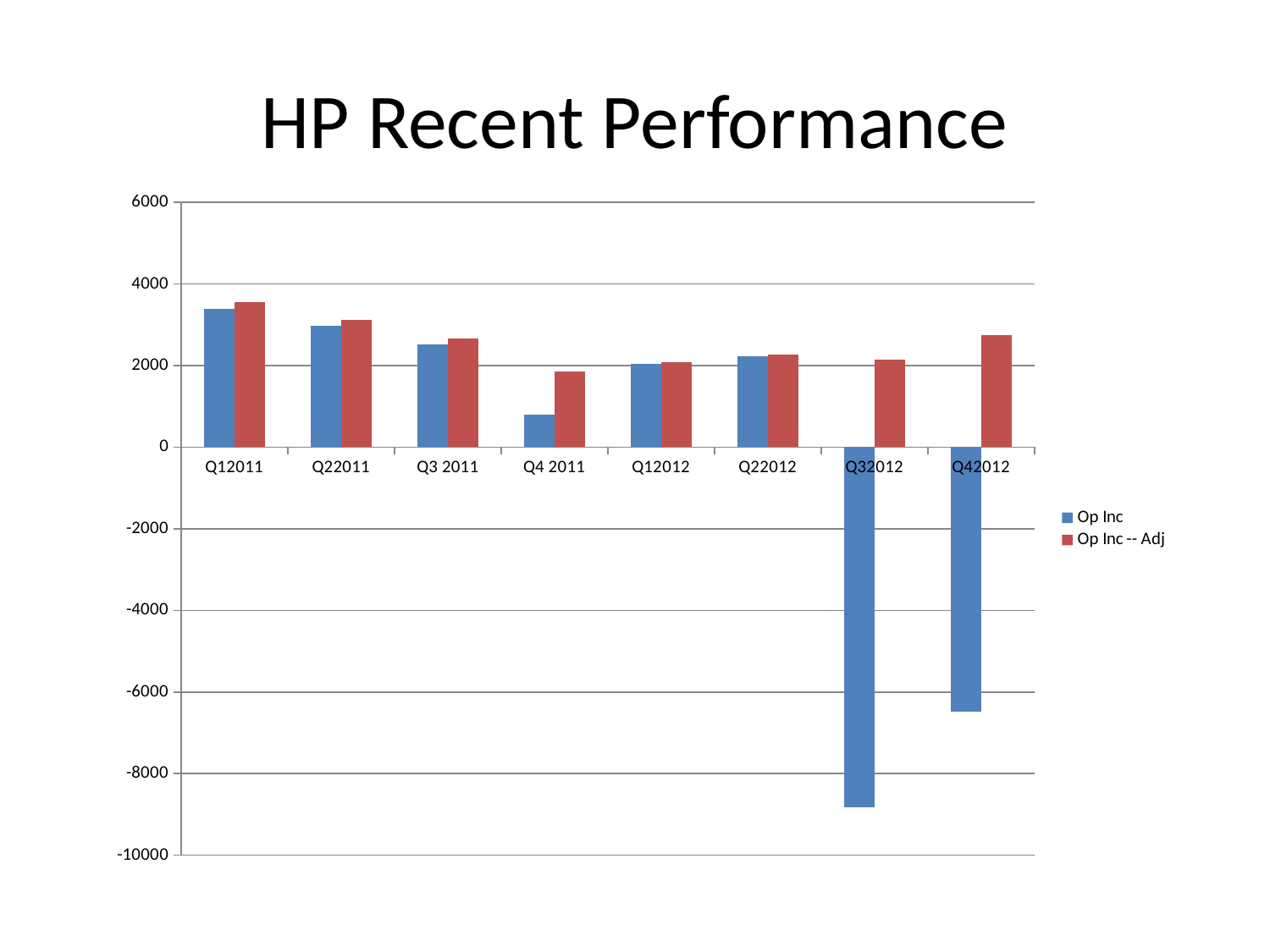
How many quarters are shown on the x axis of the chart? 8 Is the Op Inc value for Q32012 greater or less than -8000? less Which quarter has the lowest Op Inc value? Q32012 For Q4 2011, which is larger: Op Inc or Op Inc -- Adj? Op Inc -- Adj Is the Op Inc value for Q4 2011 greater or less than 2000? less Is the Op Inc -- Adj value for Q42012 greater or less than 2000? greater Do the Op Inc values rise or fall from Q12011 to Q3 2011? fall How many series does the legend list? 2 Which quarter has the highest Op Inc -- Adj value? Q12011 Which quarter has the highest Op Inc value? Q12011 What kind of chart is shown on the slide? bar chart Which quarter has the lowest Op Inc -- Adj value? Q4 2011